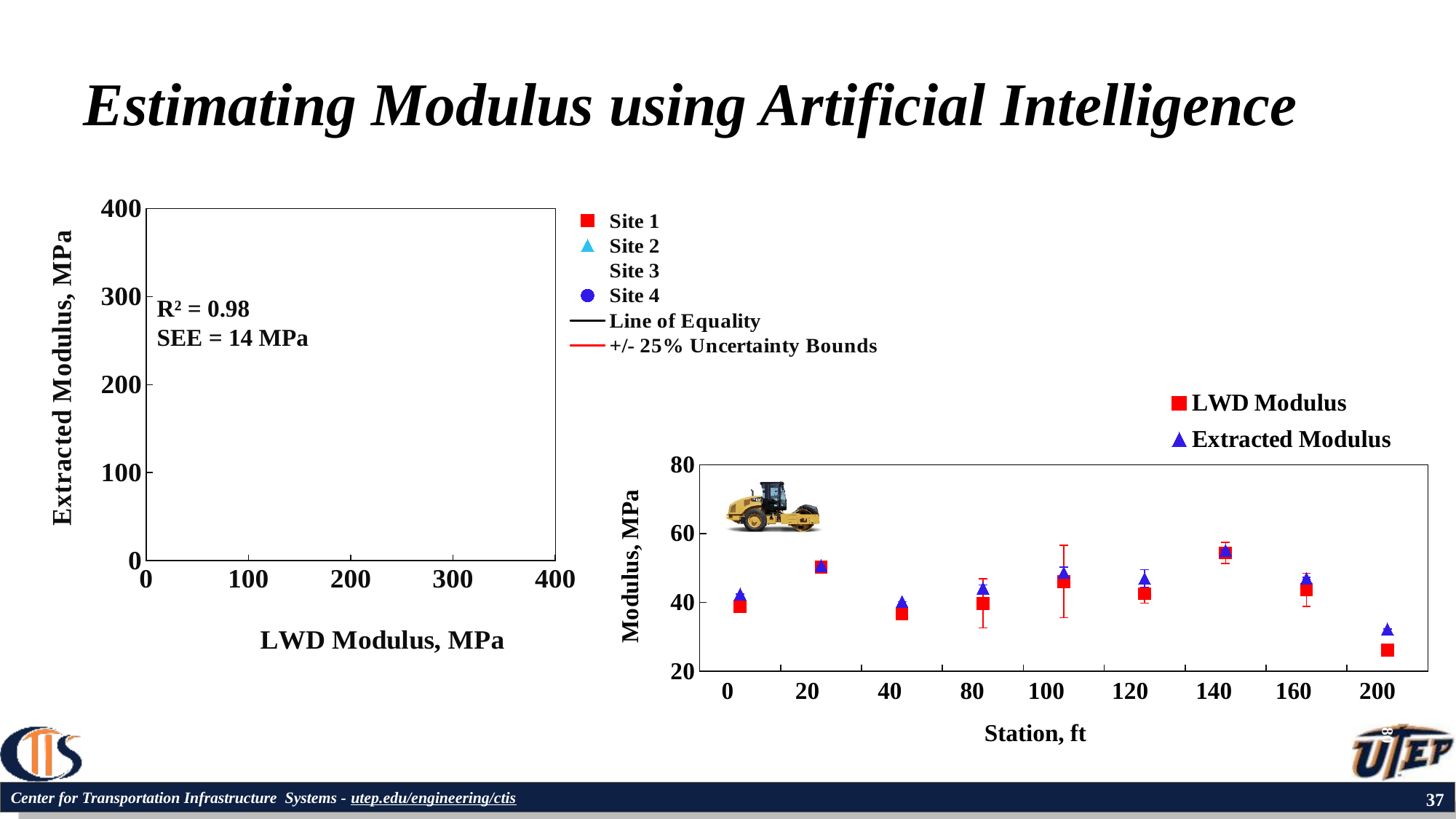
On the right chart (Modulus vs Station), is the LWD Modulus at station 200 greater or less than 40? less On the left chart (Extracted Modulus vs LWD Modulus), what SEE value is shown? 14 MPa On the right chart (Modulus vs Station), is the LWD Modulus at station 140 greater or less than 40? greater On the right chart (Modulus vs Station), how many stations have data points plotted? 9 What kind of chart is the right chart (Modulus vs Station)? scatter chart On the left chart (Extracted Modulus vs LWD Modulus), how many entries does the legend list? 6 On the right chart (Modulus vs Station), at which station is the LWD Modulus lowest? 200 On the right chart (Modulus vs Station), at station 200, which is larger: LWD Modulus or Extracted Modulus? Extracted Modulus On the right chart (Modulus vs Station), how many series does the legend list? 2 On the left chart (Extracted Modulus vs LWD Modulus), what R² value is shown? 0.98 On the right chart (Modulus vs Station), at which station is the LWD Modulus highest? 140 On the right chart (Modulus vs Station), does the LWD Modulus rise or fall from station 140 to station 200? fall